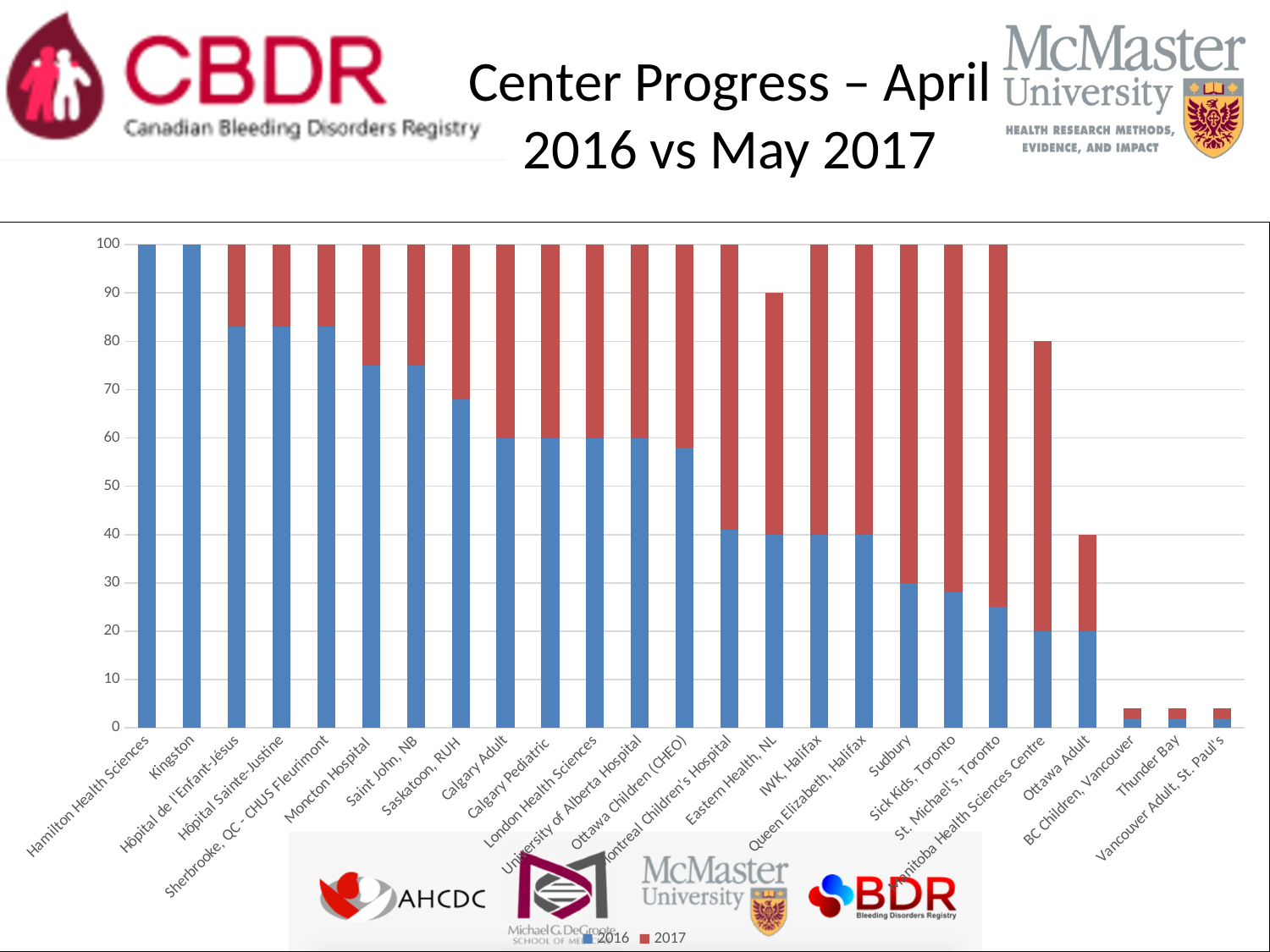
How many series does the chart legend list? 2 Is the 2016 value for Moncton Hospital greater or less than 70? greater What is the 2016 value for Hamilton Health Sciences? 100 Do the 2016 values generally rise or fall moving from left to right along the x axis? fall Is the total stacked bar for Eastern Health, NL greater or less than 80? greater Is the 2016 value for Sudbury greater or less than 40? less How many centers (categories) are plotted on the x axis? 25 What kind of chart is shown on the slide? Stacked bar chart Which has the larger 2016 value, Saskatoon, RUH or Calgary Adult? Saskatoon, RUH What are the two series named in the legend? 2016 and 2017 Which has the larger 2016 value, Kingston or Ottawa Adult? Kingston